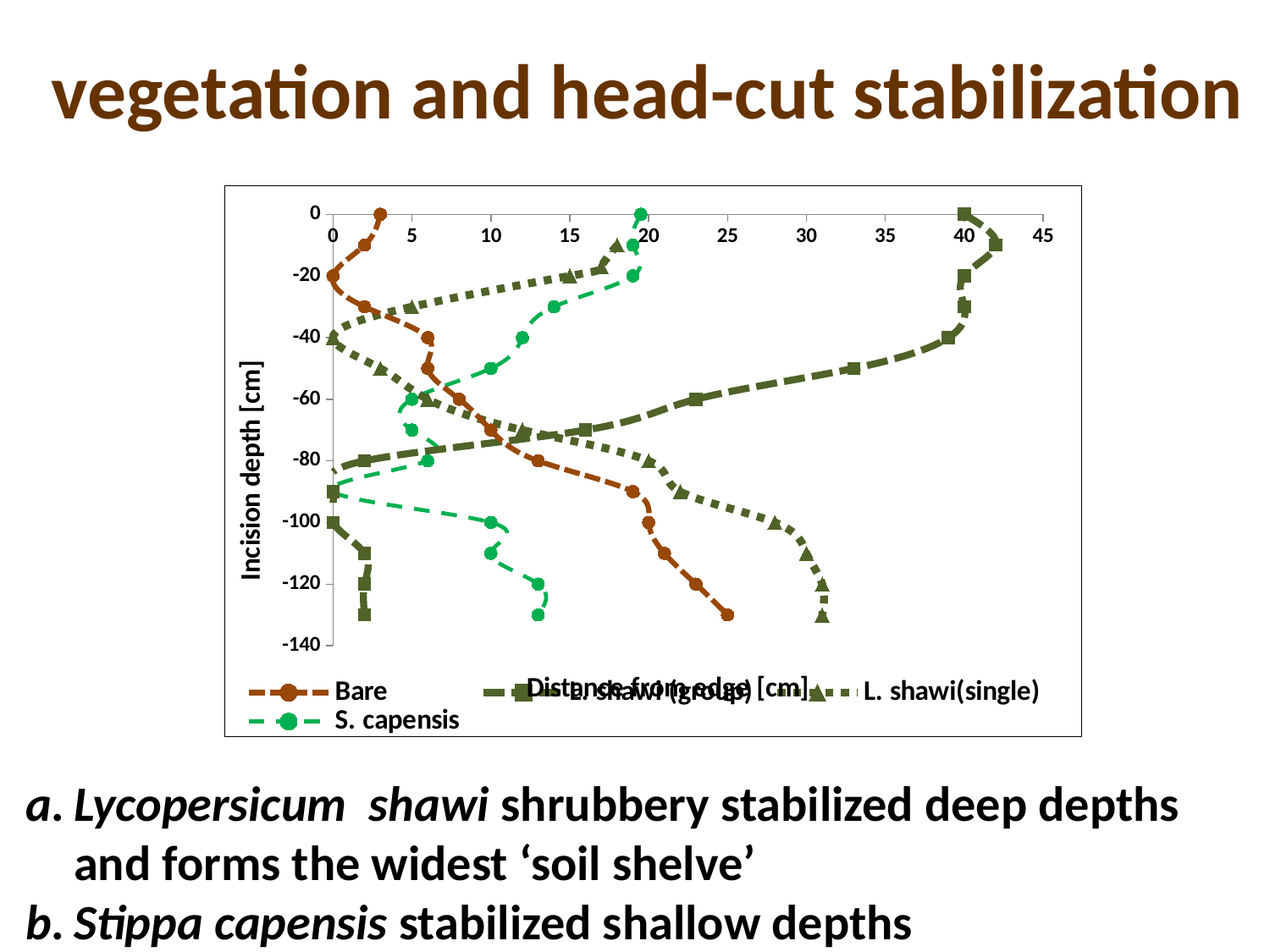
At incision depth -130, is the distance from edge for L. shawi(single) greater or less than 25? greater What are the series names listed in the legend? Bare, L. shawi (group), L. shawi(single), S. capensis At incision depth -130, is the distance from edge for S. capensis greater or less than 15? less What kind of chart is shown on the slide? line chart At incision depth 0, which series has the larger distance from edge, L. shawi (group) or Bare? L. shawi (group) At incision depth -130, which series has the larger distance from edge, Bare or S. capensis? Bare At incision depth -130, is the distance from edge for L. shawi (group) greater or less than 5? less How many series does the legend list? 4 Which series reaches the largest distance from edge anywhere on the chart? L. shawi (group) What is the title of the vertical axis? Incision depth [cm]